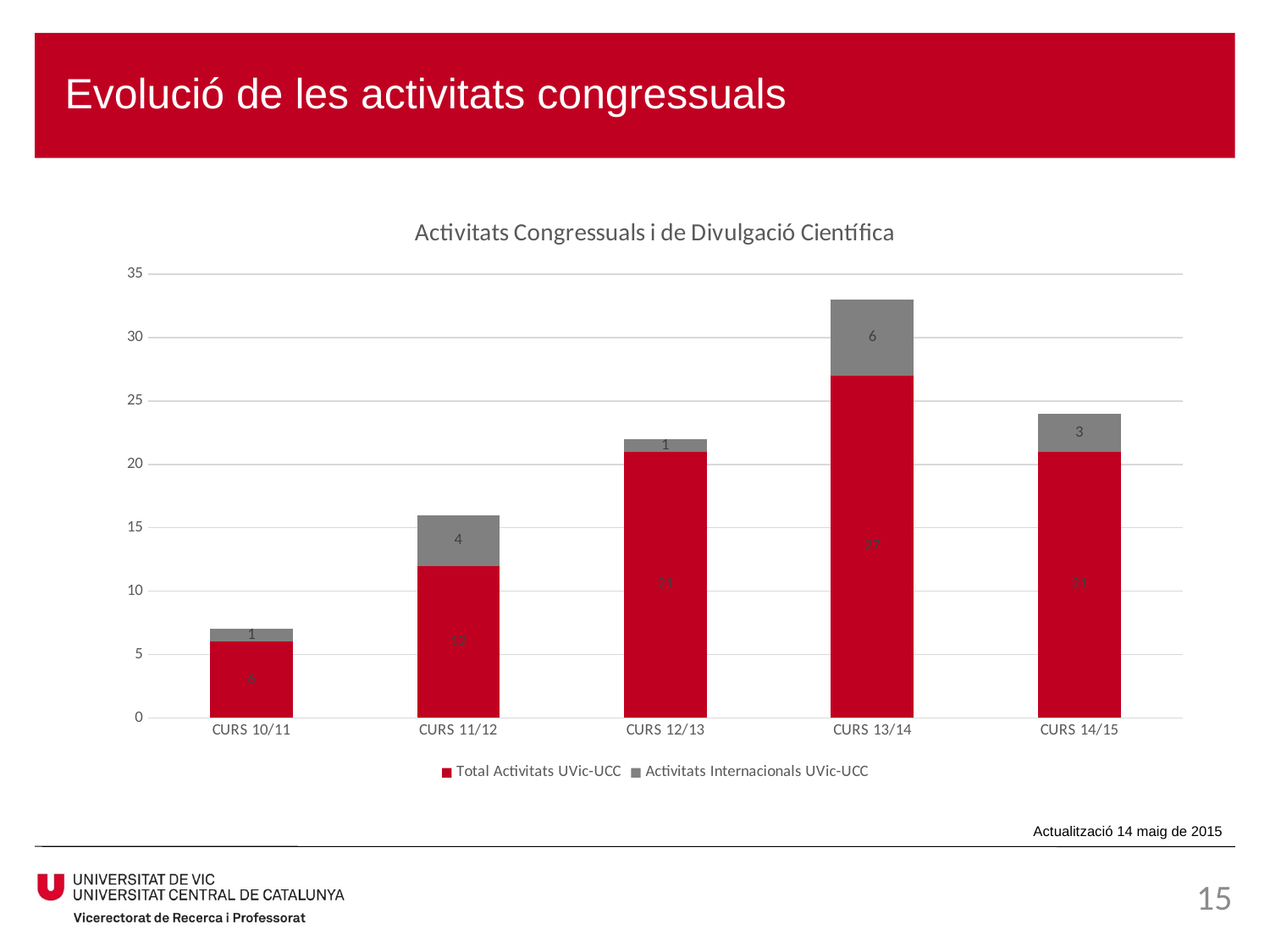
How many series does the legend list? 2 What is the difference between the Activitats Internacionals UVic-UCC values for CURS 13/14 and CURS 14/15? 3 What kind of chart is shown on the slide? Stacked bar chart What is the value of Total Activitats UVic-UCC for CURS 13/14? 27 How many academic years (categories) are shown on the x axis? 5 What is the total of the stacked bar for CURS 11/12? 16 Which academic year has the highest value for Activitats Internacionals UVic-UCC? CURS 13/14 What is the value of Activitats Internacionals UVic-UCC for CURS 13/14? 6 What is the title of the chart? Activitats Congressuals i de Divulgació Científica Which academic year has the lowest value for Total Activitats UVic-UCC? CURS 10/11 What is the value of Activitats Internacionals UVic-UCC for CURS 11/12? 4 Is the total height of the stacked bar for CURS 13/14 greater or less than 30? greater